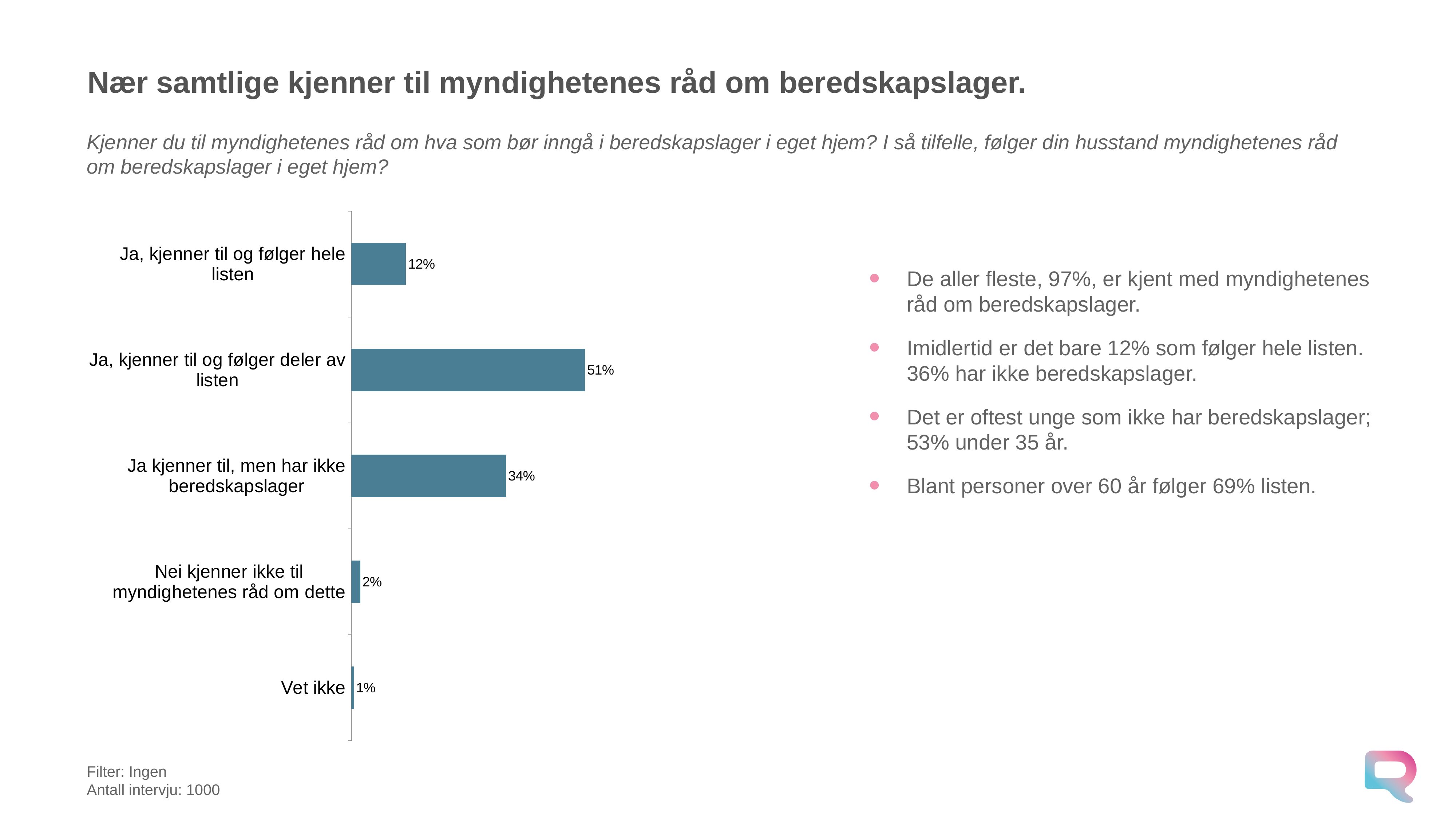
What is the number of interviews (Antall intervju) stated on the slide? 1000 What is the value for "Ja, kjenner til og følger hele listen"? 12% What is the value for "Ja kjenner til, men har ikke beredskapslager"? 34% How many categories are shown in the chart? 5 What is the value for "Nei kjenner ikke til myndighetenes råd om dette"? 2% Which category has the highest value? Ja, kjenner til og følger deler av listen What is the difference between "Ja, kjenner til og følger deler av listen" and "Ja kjenner til, men har ikke beredskapslager"? 17% Which is larger: "Ja, kjenner til og følger hele listen" or "Ja kjenner til, men har ikke beredskapslager"? Ja kjenner til, men har ikke beredskapslager What kind of chart is shown on the slide? Bar chart Which category has the lowest value? Vet ikke What is the value for "Ja, kjenner til og følger deler av listen"? 51% What is the value for "Vet ikke"? 1%